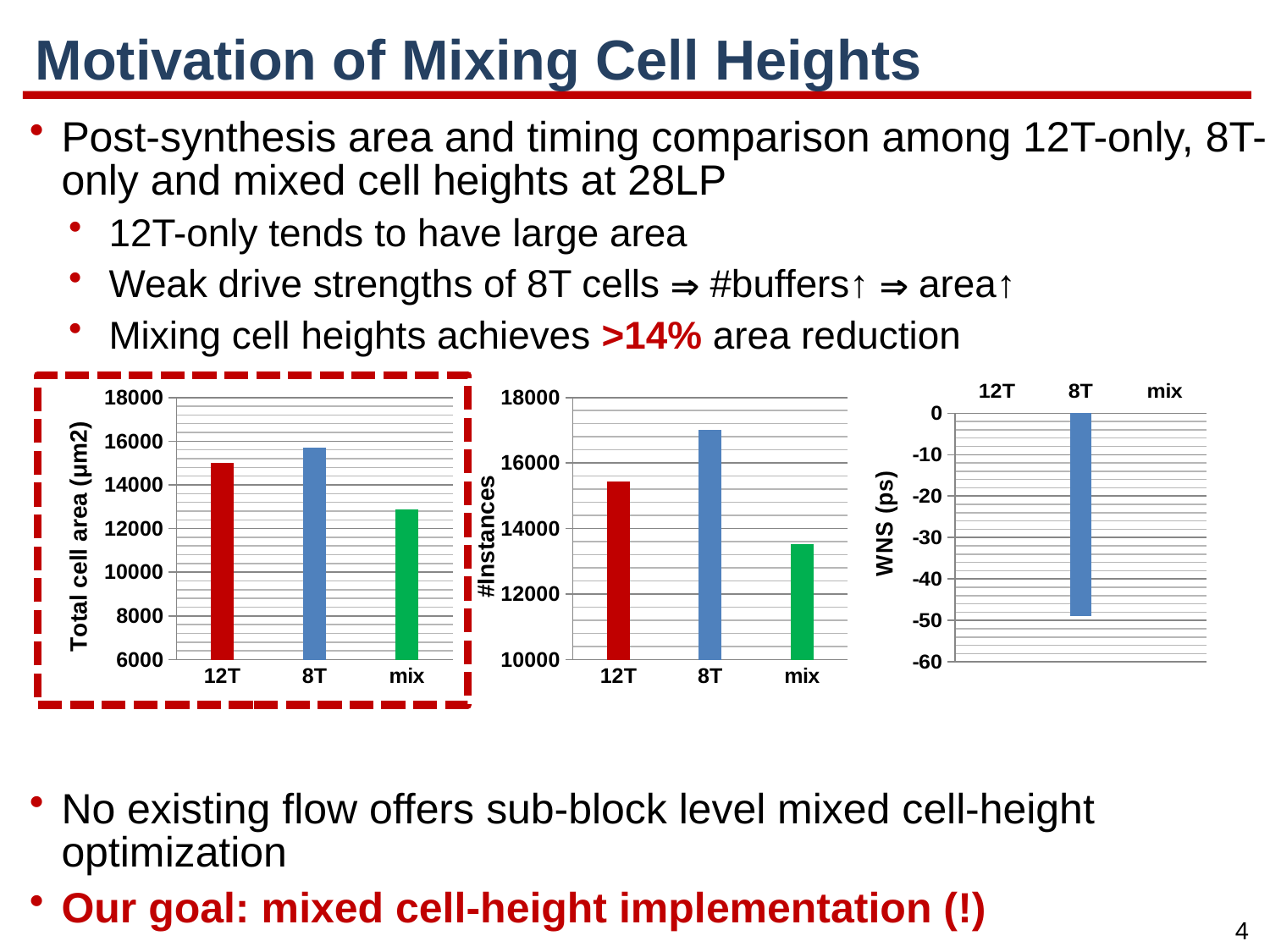
In the Total cell area chart, is the value for mix greater or less than 14000? less In the #Instances chart, is the value for mix greater or less than 14000? less In the Total cell area chart, which category has the highest total cell area? 8T In the #Instances chart, which category has the lowest number of instances? mix In the WNS (ps) chart, is the value for 8T greater or less than -40? less In the Total cell area chart, which category has the lowest total cell area? mix In the #Instances chart, which category has the highest number of instances? 8T In the WNS (ps) chart, which category has a non-zero WNS bar? 8T What kind of chart is the #Instances chart? bar chart How many categories are shown on the x axis of the Total cell area chart? 3